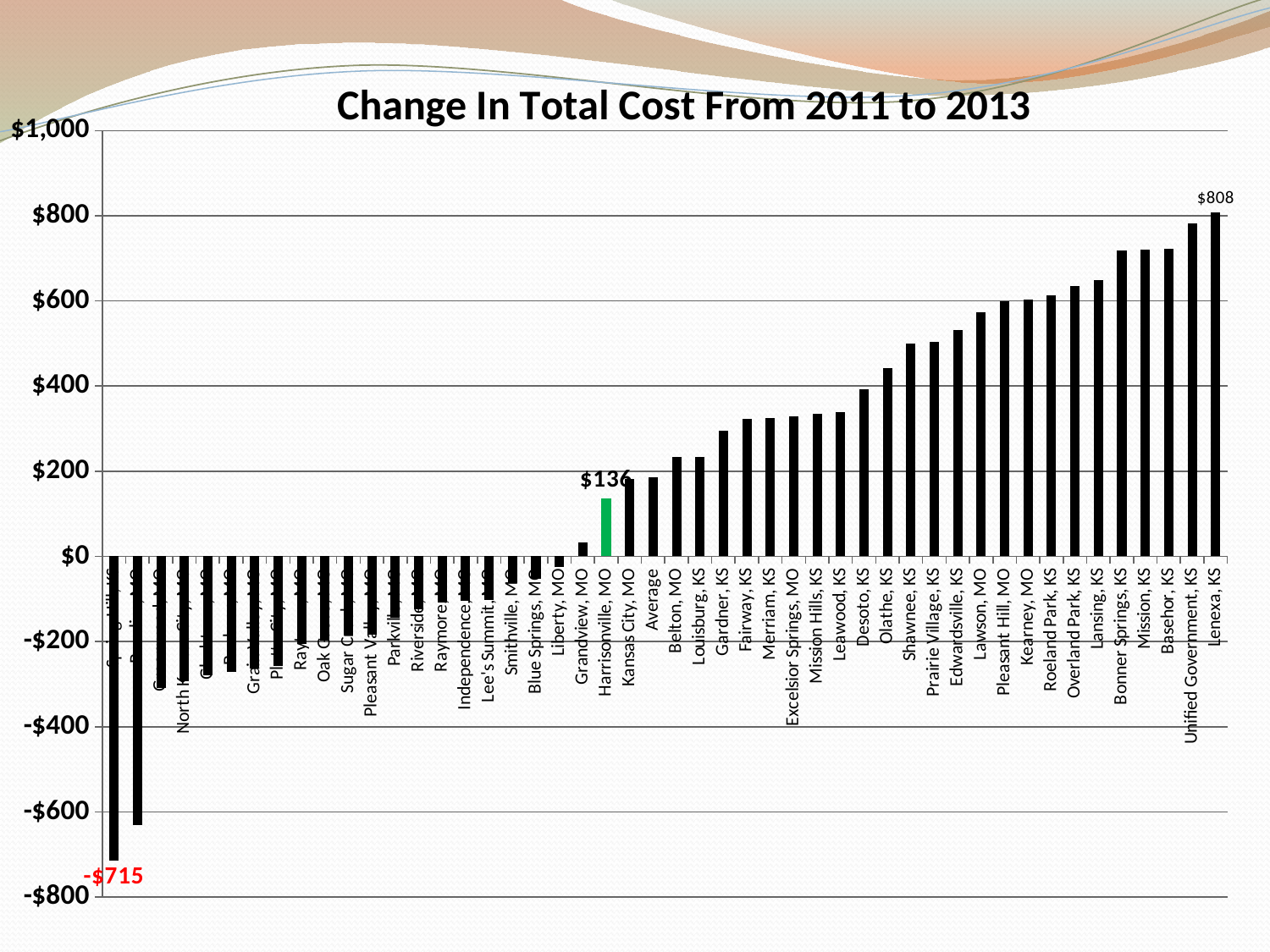
What is the title of the chart? Change In Total Cost From 2011 to 2013 How much larger is the value for Lenexa, KS than the value for Harrisonville, MO? $672 What is the change in total cost for Lenexa, KS? $808 Which city's bar is coloured green? Harrisonville, MO Is the value for Unified Government, KS greater or less than $600? greater What is the change in total cost for Harrisonville, MO? $136 Is the value for Leawood, KS greater or less than $400? less What is the lowest value labelled on the chart? -$715 What kind of chart is shown on the slide? bar chart Which city has the highest change in total cost? Lenexa, KS Do the values generally rise or fall from left to right along the x axis? rise Which has the larger value, Bonner Springs, KS or Olathe, KS? Bonner Springs, KS